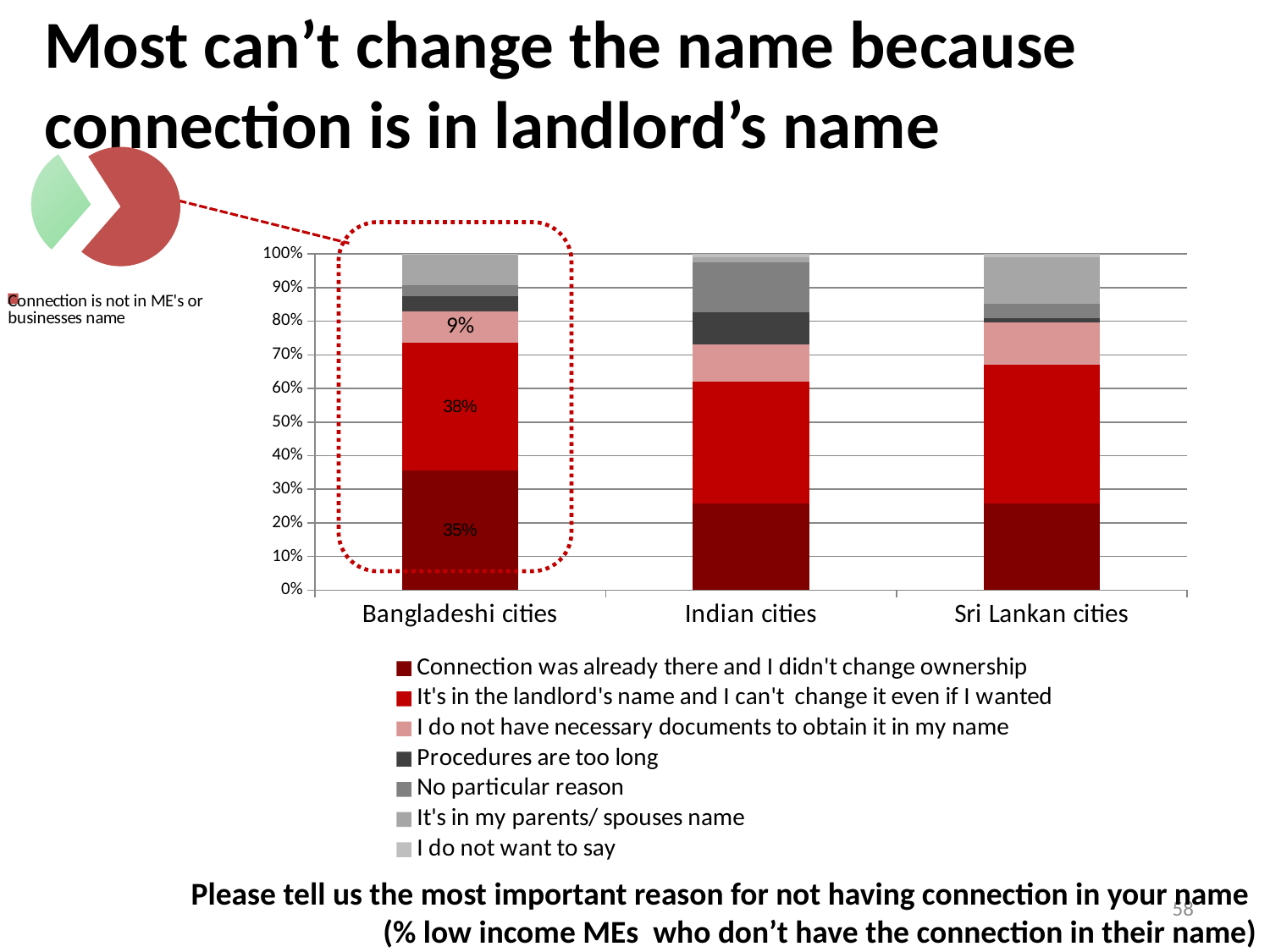
How many reasons (series) does the chart legend list? 7 Which city group has the largest 'Procedures are too long' segment? Indian cities Which city group has the largest 'No particular reason' segment? Indian cities In the Bangladeshi cities bar, what percentage is shown for 'It's in the landlord's name and I can't change it even if I wanted'? 38% For Bangladeshi cities, which is larger: the 'It's in the landlord's name' share or the 'I do not have necessary documents' share? It's in the landlord's name In the Bangladeshi cities bar, what percentage is shown for 'I do not have necessary documents to obtain it in my name'? 9% In the Bangladeshi cities bar, what percentage is shown for 'Connection was already there and I didn't change ownership'? 35% For Bangladeshi cities, what is the difference between the 'landlord's name' share (38%) and the 'connection was already there' share (35%)? 3 percentage points How many city groups (categories) are shown on the x axis of the chart? 3 Which category's bar is highlighted with a red dashed outline on the slide? Bangladeshi cities What kind of chart is shown on the slide? Stacked bar chart Is the 'Connection was already there and I didn't change ownership' segment for Indian cities greater or less than 20%? greater